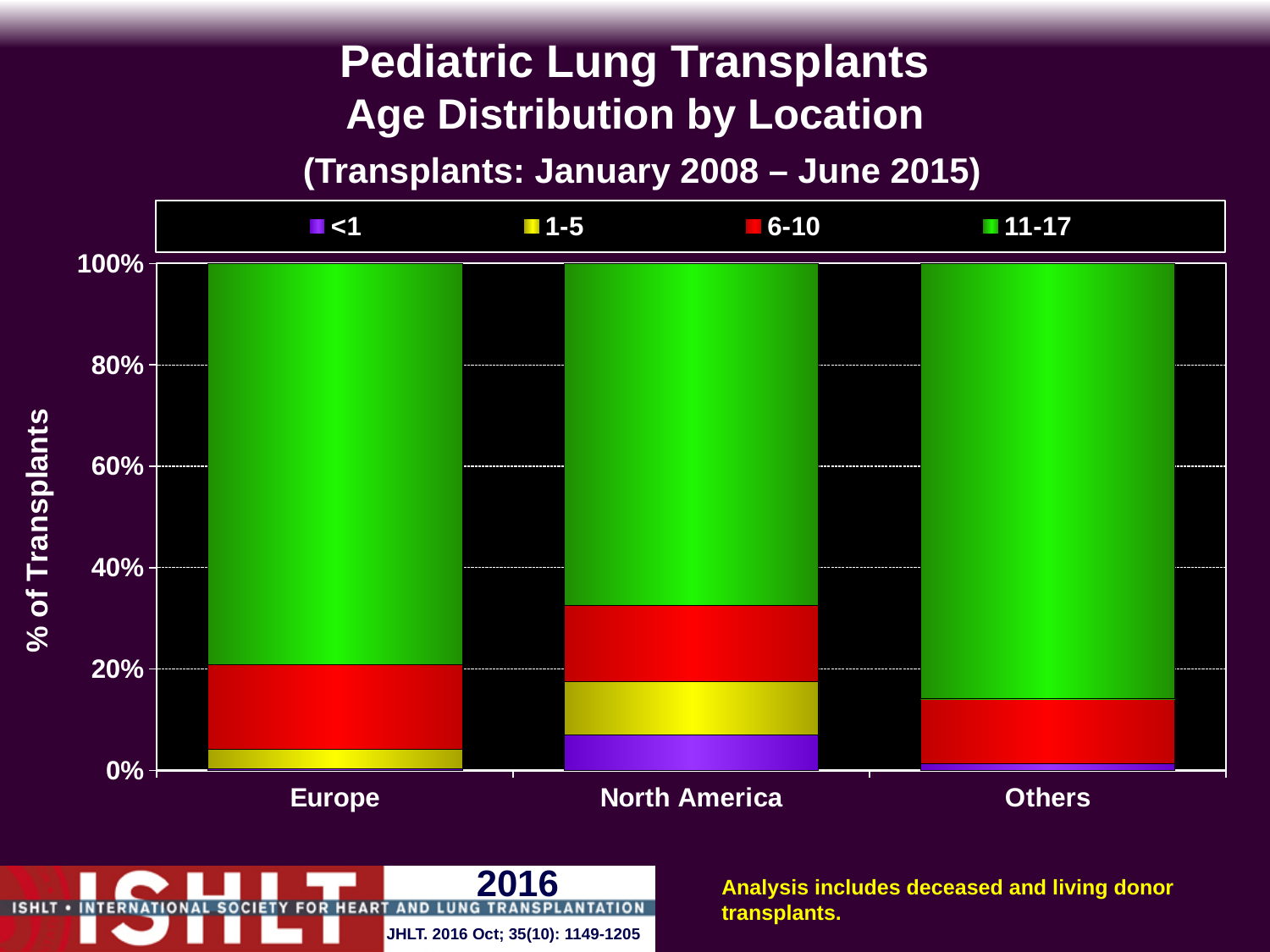
Is the combined share of the <1, 1-5 and 6-10 age groups for North America greater or less than 20%? greater How many locations are shown on the x axis of the chart? 3 Which location has the largest share of transplants in the 11-17 age group? Others Which age group is shown in green in the chart? 11-17 Which location has the largest share of transplants in the <1 age group? North America Is the combined share of the <1, 1-5 and 6-10 age groups for Others greater or less than 20%? less How many age groups does the legend list? 4 What kind of chart is shown on the slide? Stacked bar chart What is the label of the y axis? % of Transplants Which location has the largest share of transplants in the 1-5 age group? North America Is the share of the 11-17 age group for Europe greater or less than 60%? greater Which location has the smallest share of transplants in the 11-17 age group? North America